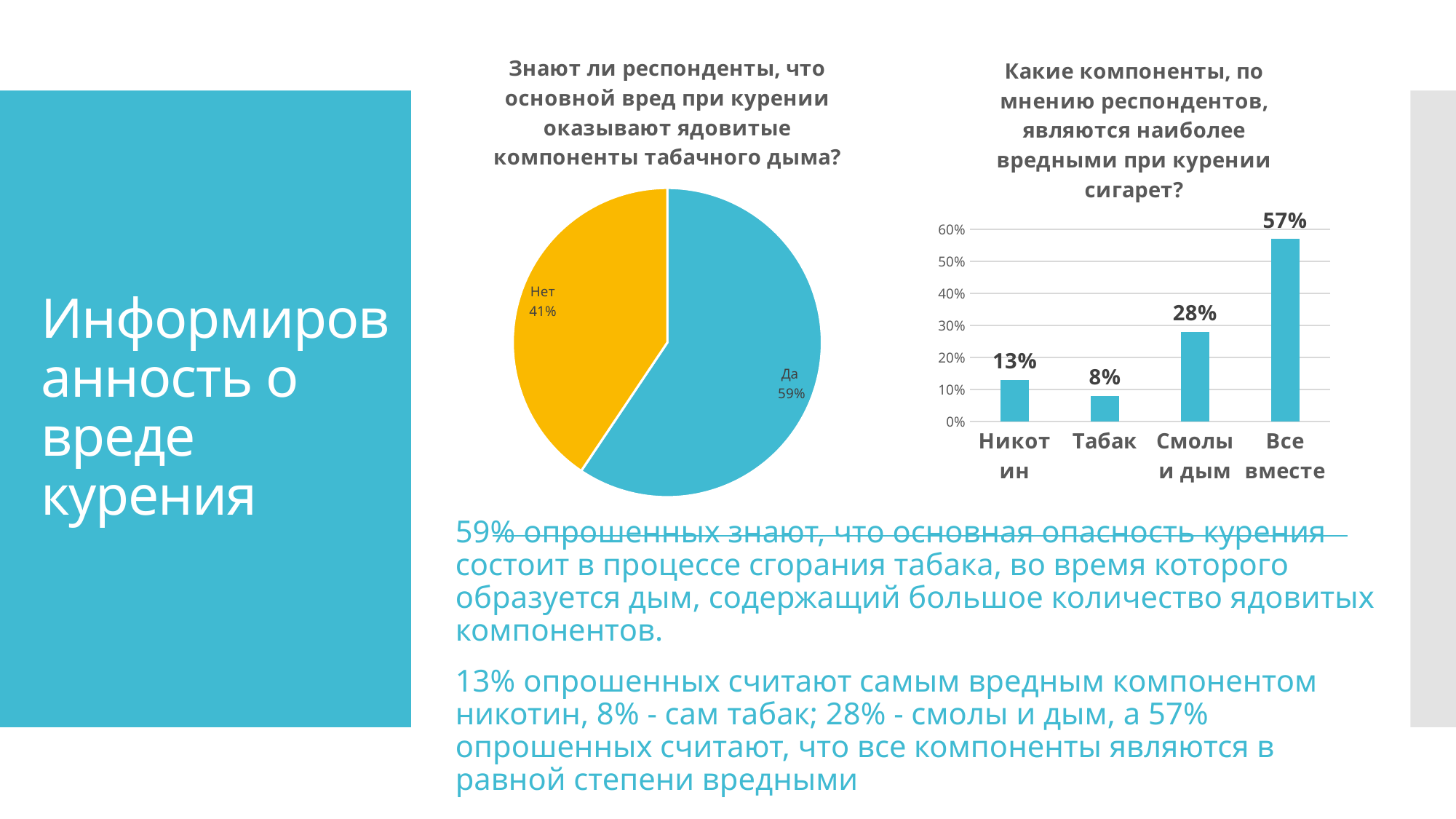
In the pie chart on the left, which answer has the larger share, "Да" or "Нет"? Да In the pie chart on the left, what share of respondents answered "Нет"? 41% In the pie chart on the left, what share of respondents answered "Да"? 59% In the bar chart on the right, what is the value for "Никотин"? 13% In the bar chart on the right, which category has the highest value? Все вместе What kind of chart is the chart on the right? Bar chart In the bar chart on the right, which category has the lowest value? Табак In the bar chart on the right, what is the difference between "Все вместе" and "Смолы и дым"? 29% In the bar chart on the right, what is the value for "Смолы и дым"? 28% In the bar chart on the right, how many categories are shown? 4 In the pie chart on the left, how many slices are there? 2 What kind of chart is the chart on the left? Pie chart